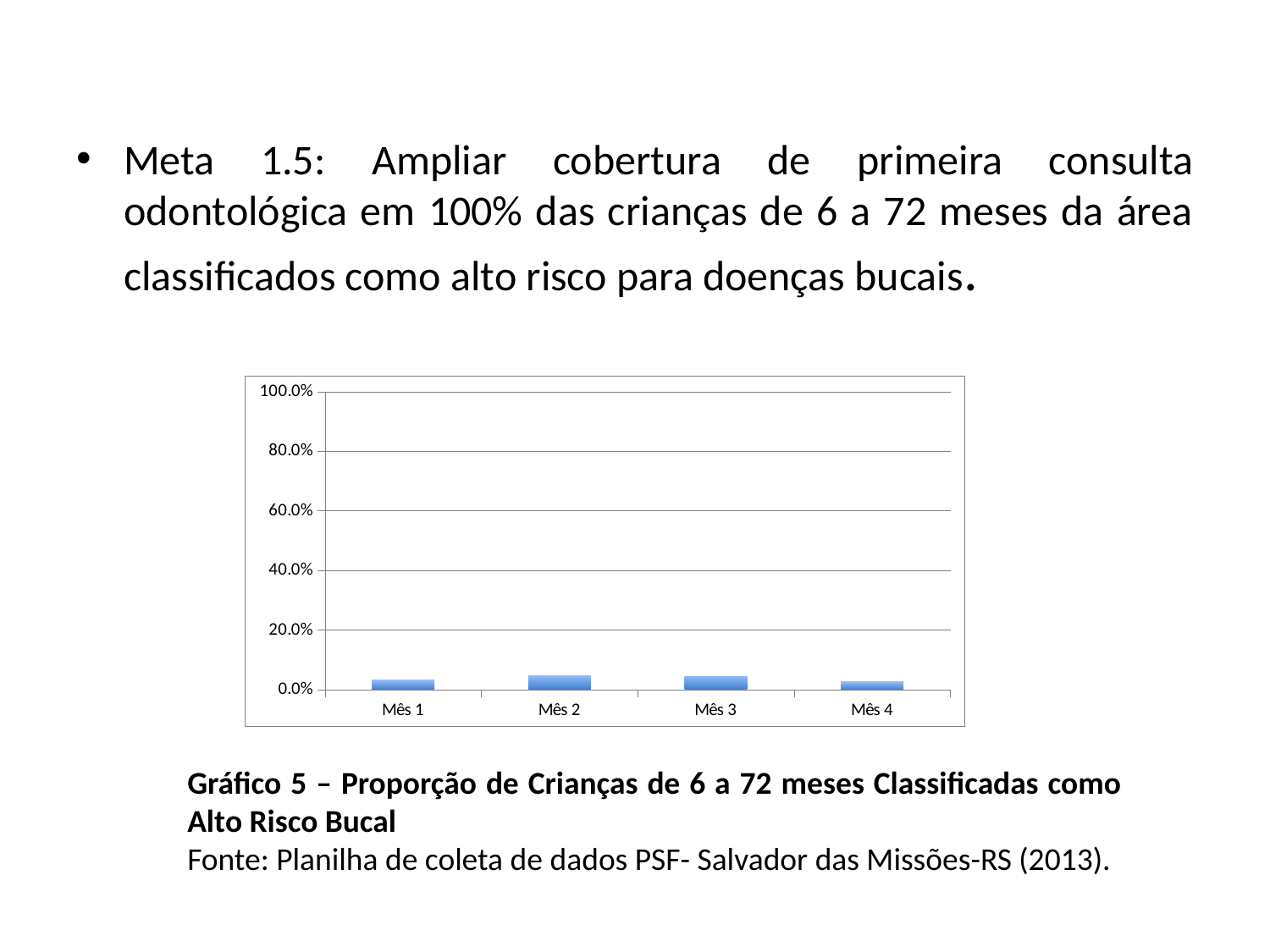
Is the value for Mês 1 greater or less than 20.0%? less Which is larger, the value for Mês 3 or the value for Mês 4? Mês 3 What is the label of the first category on the x axis? Mês 1 Is the value for Mês 4 greater or less than 20.0%? less How many categories (months) are plotted on the x axis of the chart? 4 Is the value for Mês 3 greater or less than 40.0%? less What kind of chart is shown on the slide? bar chart Which is larger, the value for Mês 2 or the value for Mês 4? Mês 2 What is the highest value shown on the y axis of the chart? 100.0%